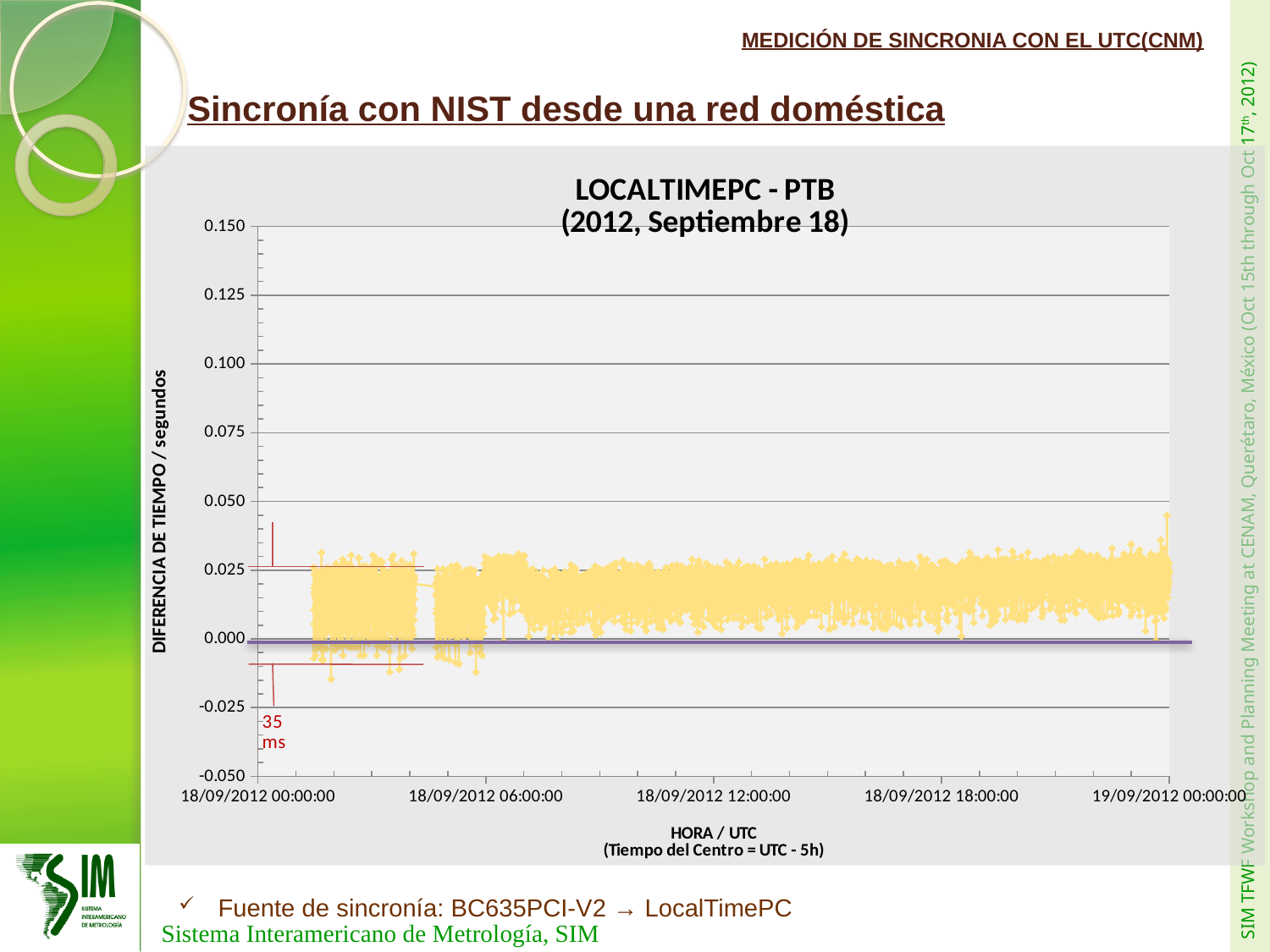
What is the first date-time label on the horizontal axis of the chart? 18/09/2012 00:00:00 What kind of chart is shown on the slide? line chart What is the label of the vertical axis of the chart? DIFERENCIA DE TIEMPO / segundos How many labelled tick marks are there on the horizontal axis of the chart? 5 Are the plotted time-difference values at 18/09/2012 18:00:00 greater or less than 0.100 seconds? less What is the last date-time label on the horizontal axis of the chart? 19/09/2012 00:00:00 Are the plotted time-difference values at 18/09/2012 12:00:00 greater or less than 0.050 seconds? less What is the title of the chart? LOCALTIMEPC - PTB (2012, Septiembre 18) What is the highest value shown on the vertical axis of the chart? 0.150 What value is written in the red annotation near the start of the plotted data? 35 ms What is the lowest value shown on the vertical axis of the chart? -0.050 Do the plotted values show a strong rising trend, a strong falling trend, or stay roughly flat across the day? roughly flat